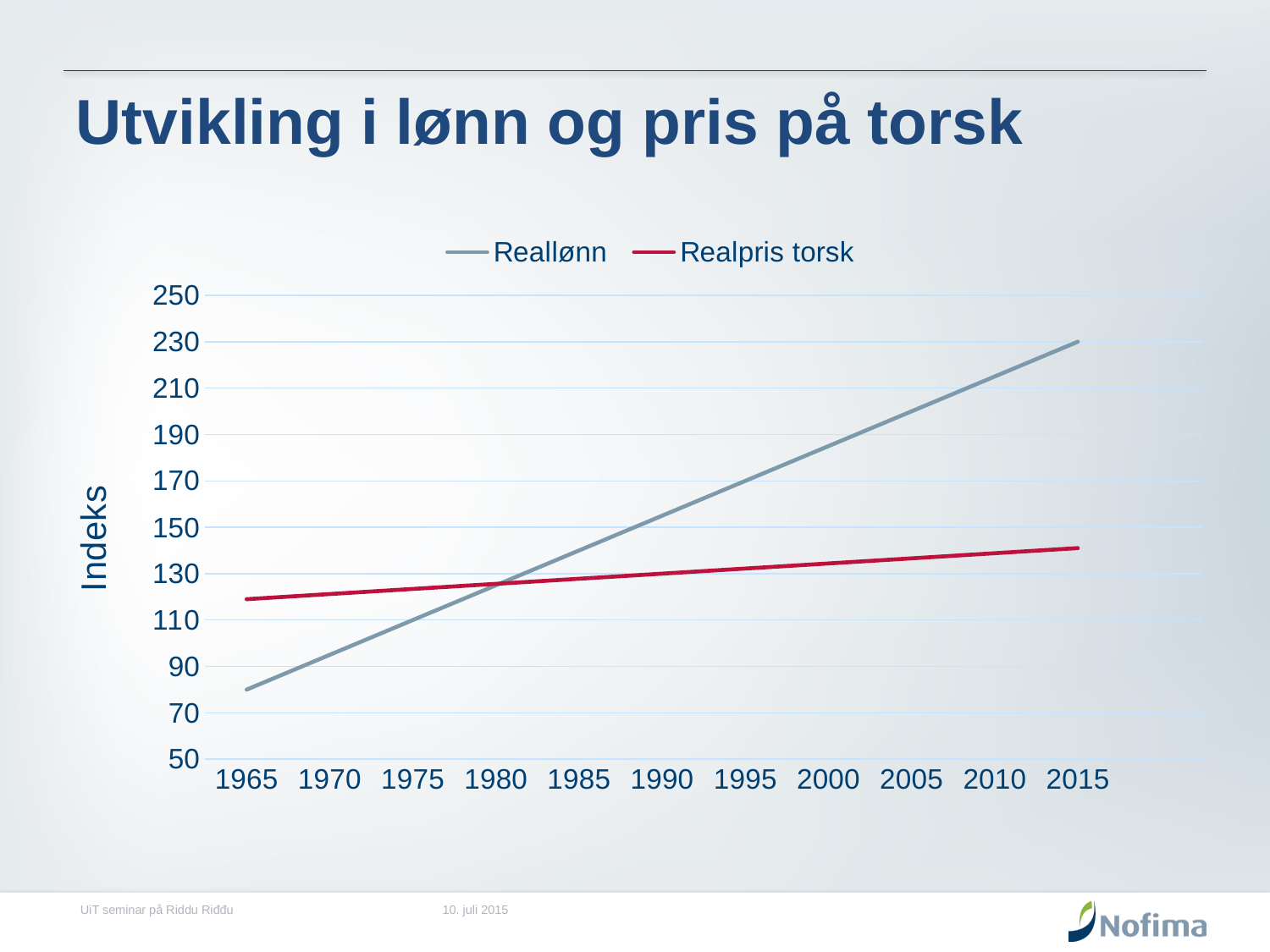
Does the Realpris torsk line rise or fall from 1965 to 2015? rise In 1965, which series has the higher value, Reallønn or Realpris torsk? Realpris torsk What kind of chart is shown on the slide? line chart How many year labels are shown on the x axis? 11 In 2015, which series has the higher value, Reallønn or Realpris torsk? Reallønn Does the Reallønn line rise or fall from 1965 to 2015? rise How many series does the legend list? 2 Is the value for Reallønn in 2015 greater or less than 210? greater What are the two series named in the legend? Reallønn and Realpris torsk Is the value for Realpris torsk in 2015 greater or less than 130? greater Is the value for Reallønn in 1965 greater or less than 90? less What is the label on the vertical axis? Indeks